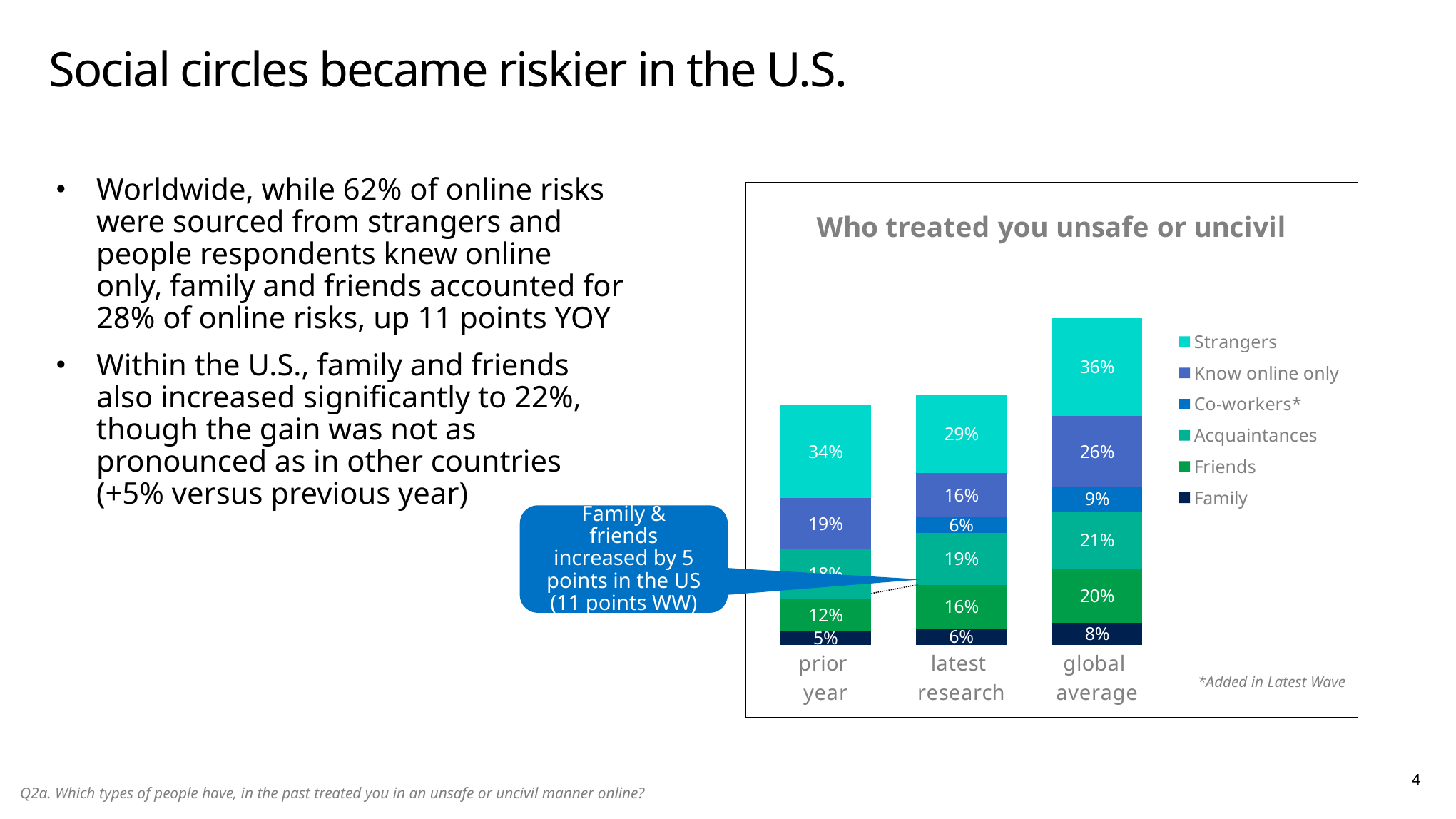
Is the Know online only value larger in the global average bar or the latest research bar? global average What is the value for Co-workers in the latest research bar? 6% In the 'Who treated you unsafe or uncivil' chart, what is the value for Strangers in the global average bar? 36% What is the value for Family in the prior year bar? 5% By how many percentage points did the Friends value change from prior year to latest research? 4 percentage points How many bars (categories) are shown on the x axis? 3 Which bar has the highest value for Strangers? global average What is the value for Friends in the global average bar? 20% Which bar has the lowest value for Family? prior year What is the title of the chart? Who treated you unsafe or uncivil What kind of chart is shown on the slide? Stacked bar chart How many series does the legend list? 6